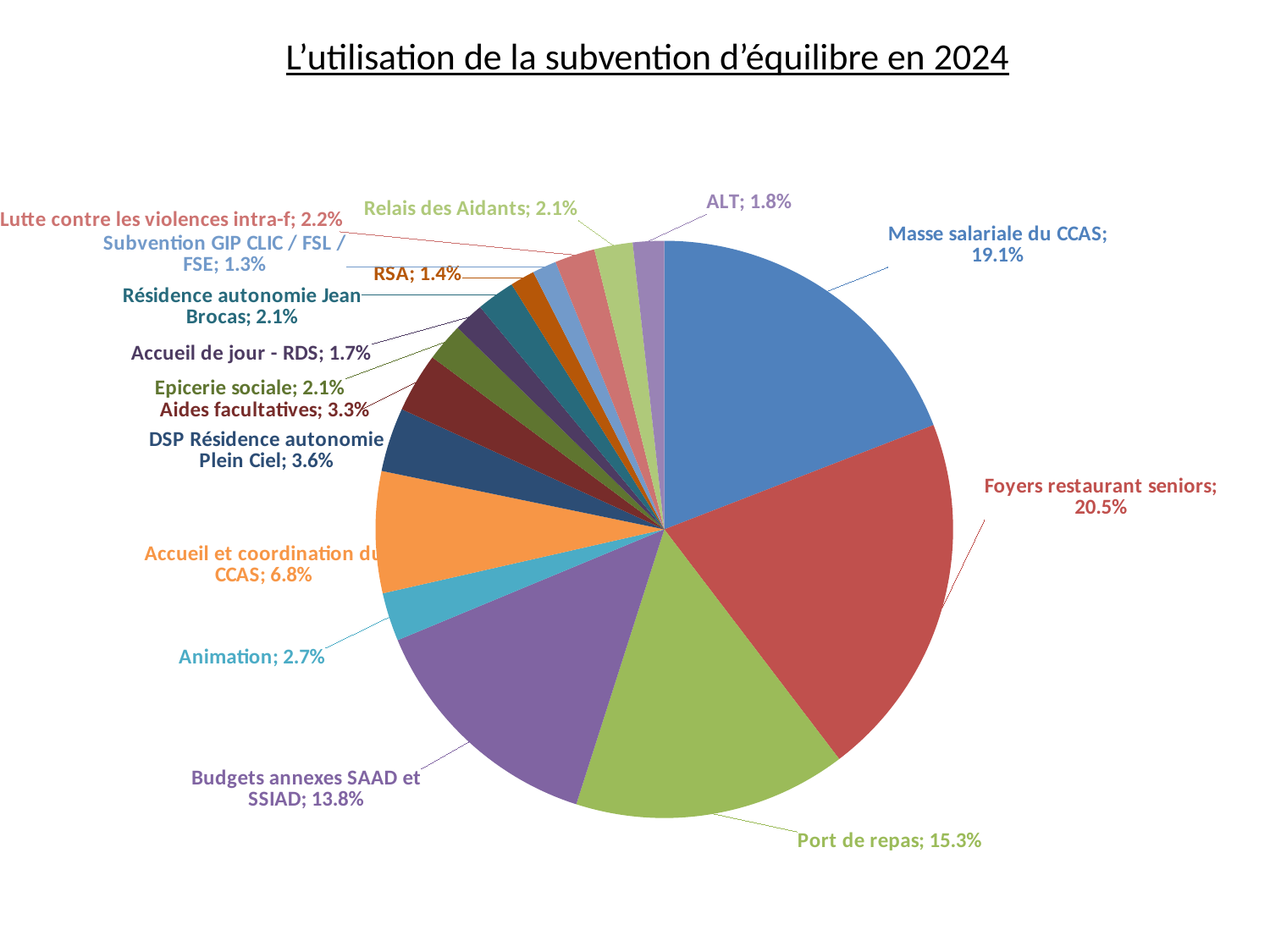
What kind of chart is shown on the slide? Pie chart What is the value shown for RSA? 1.4% What is the difference between the shares of Foyers restaurant seniors and Port de repas? 5.2% What is the title of the slide? L'utilisation de la subvention d'équilibre en 2024 What is the value shown for Masse salariale du CCAS? 19.1% What is the value shown for Accueil et coordination du CCAS? 6.8% Which category has the largest slice of the pie? Foyers restaurant seniors Which is larger, the share for Animation or the share for DSP Résidence autonomie Plein Ciel? DSP Résidence autonomie Plein Ciel Which category has the smallest slice of the pie? Subvention GIP CLIC / FSL / FSE How many categories are shown in the pie chart? 16 What is the value shown for Budgets annexes SAAD et SSIAD? 13.8% What share of the pie does Foyers restaurant seniors represent? 20.5%